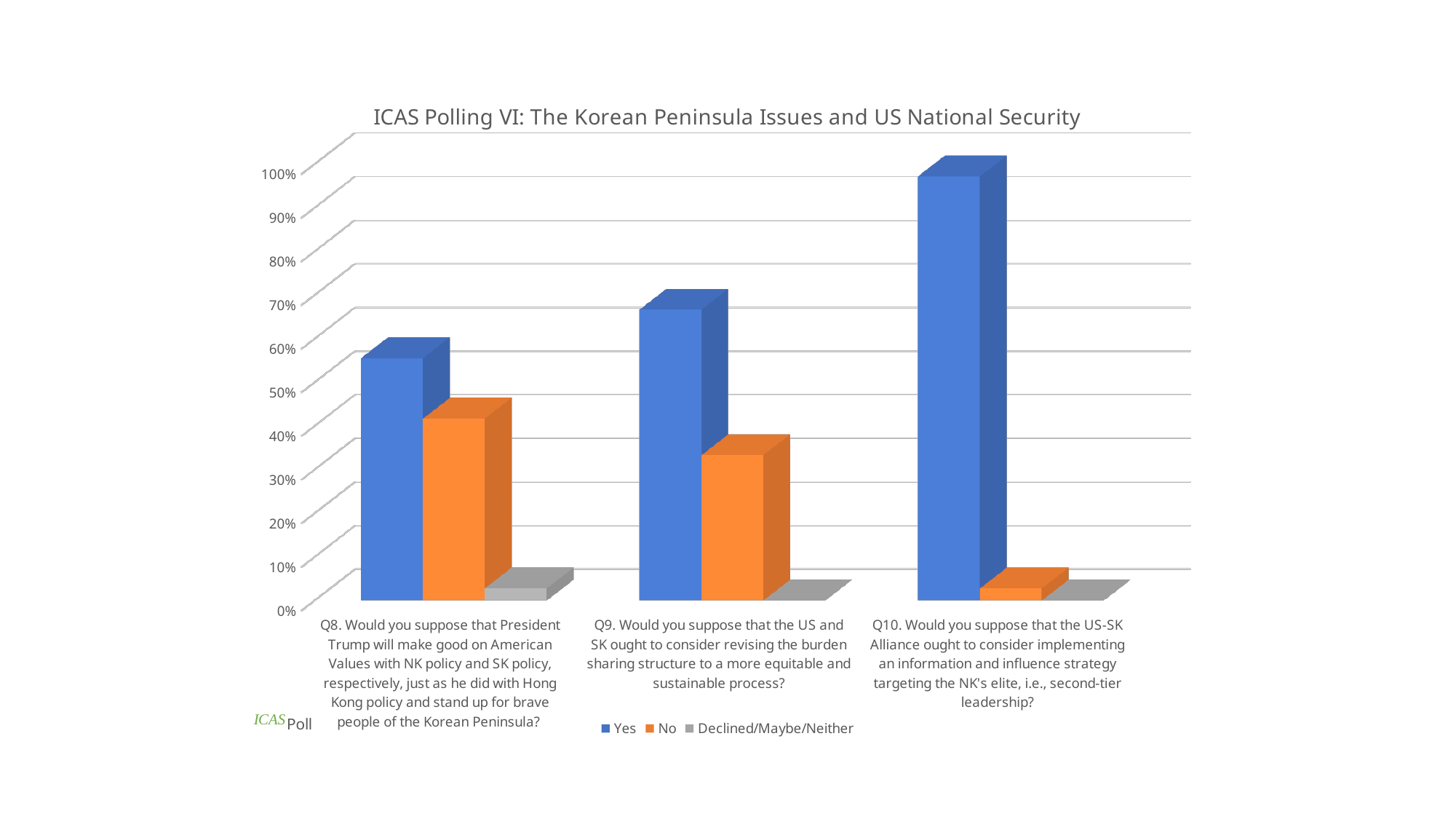
Is the Yes value for Q10 greater or less than 90%? greater Which series is shown in orange in the legend? No What is the title of the chart? ICAS Polling VI: The Korean Peninsula Issues and US National Security For Q8, which response has the lowest bar? Declined/Maybe/Neither Is the Yes value for Q9 greater or less than 60%? greater What kind of chart is shown on the slide? bar chart Is the No value for Q9 greater or less than 40%? less Which bar is the highest in the chart? Yes for Q10 How many poll questions (categories) are shown on the x axis? 3 For Q8, which is larger, the Yes value or the No value? Yes How many series does the legend list? 3